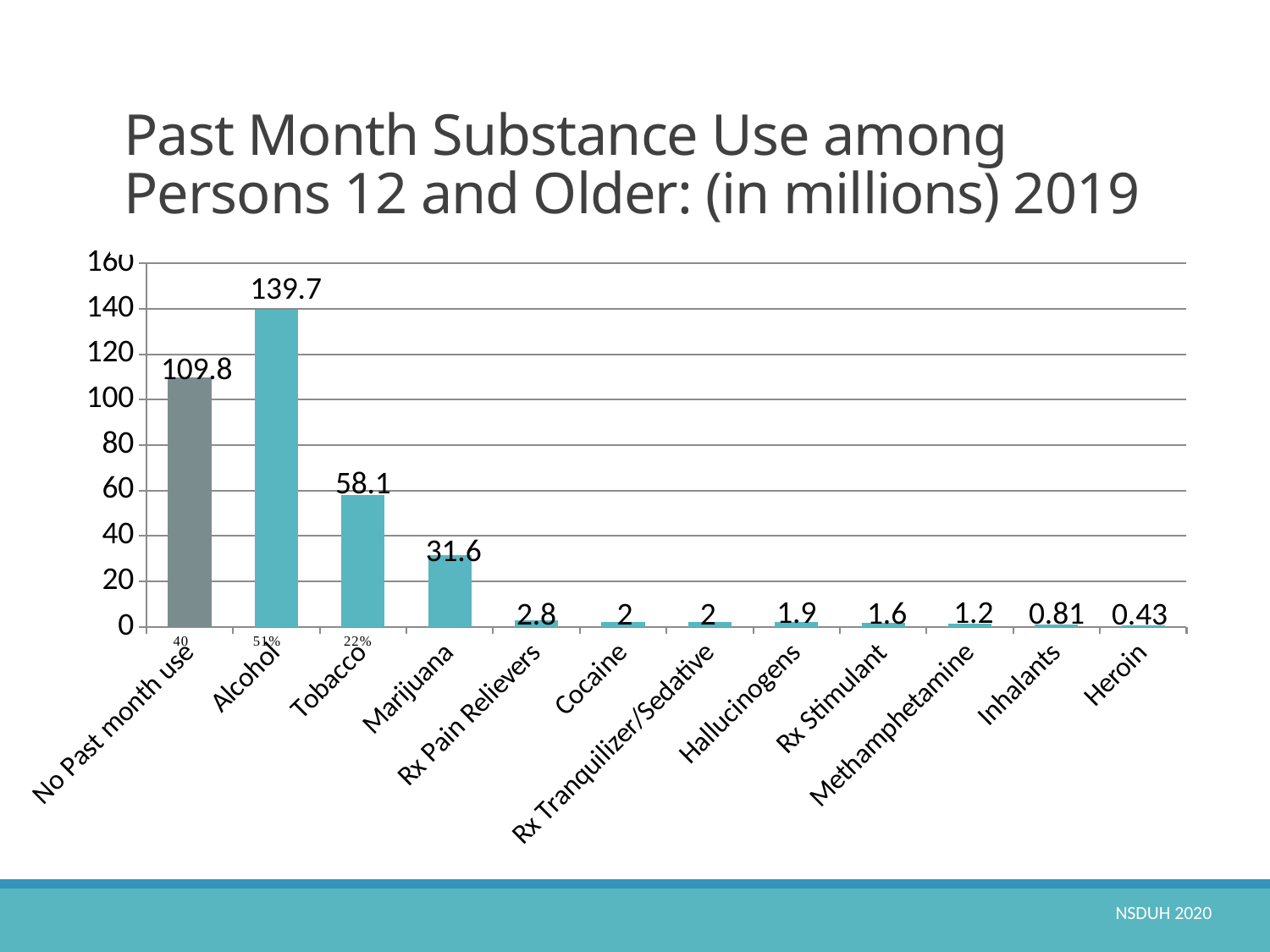
What is the value for Inhalants? 0.81 Which category has the highest value? Alcohol What is the title of the chart? Past Month Substance Use among Persons 12 and Older: (in millions) 2019 Which category has the lowest value? Heroin How many categories are shown on the x axis? 12 What is the value for Tobacco? 58.1 What is the difference between the values for Tobacco and Marijuana? 26.5 What kind of chart is shown on the slide? Bar chart What is the difference between the values for Alcohol and No Past month use? 29.9 Which is larger, the value for Marijuana or the value for Tobacco? Tobacco What is the value for Heroin? 0.43 What is the value for Alcohol? 139.7